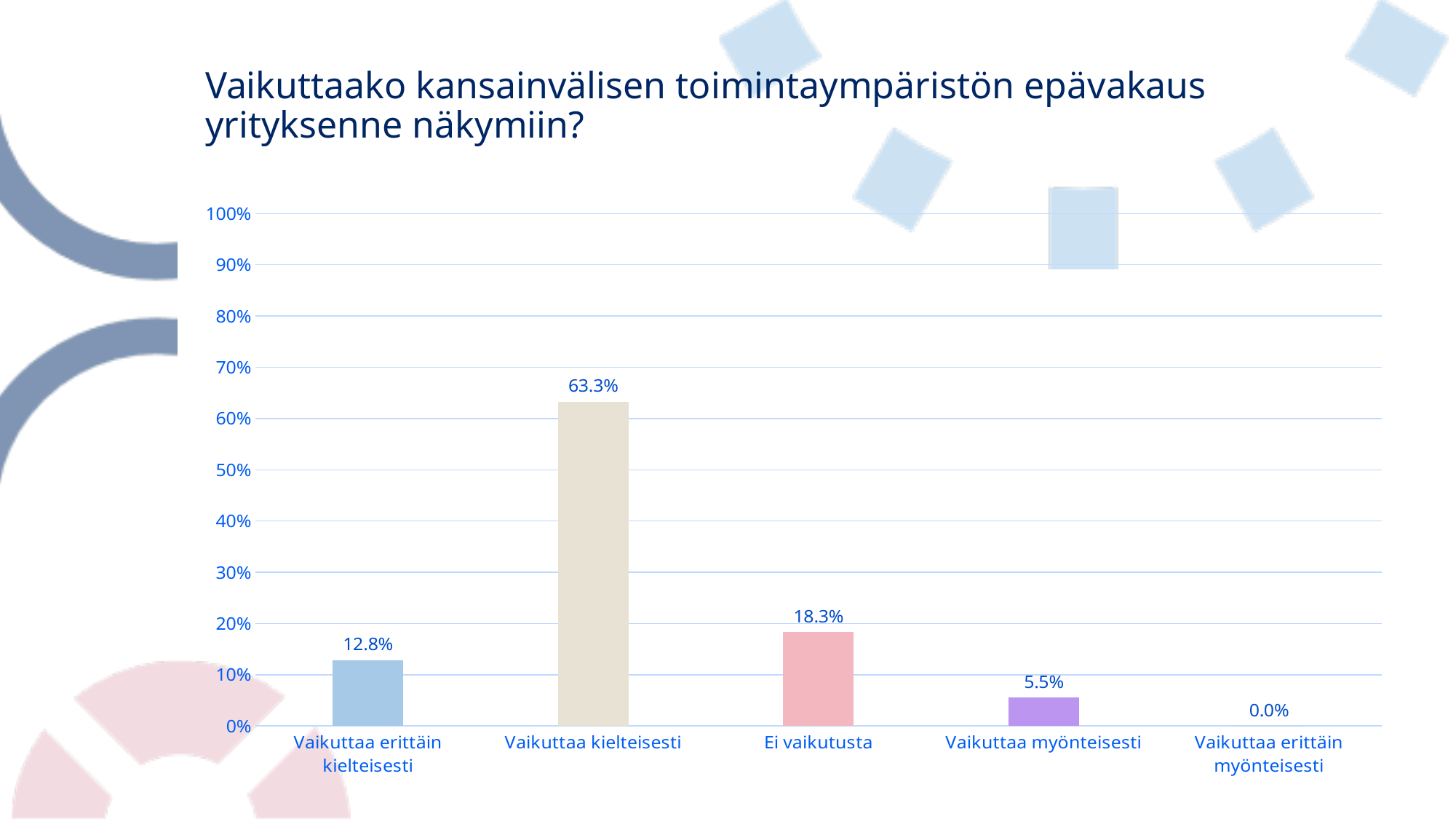
Which is larger, the value for "Ei vaikutusta" or the value for "Vaikuttaa erittäin kielteisesti"? Ei vaikutusta Which category has the highest value? Vaikuttaa kielteisesti What is the value for "Vaikuttaa erittäin kielteisesti"? 12.8% What is the title of the slide? Vaikuttaako kansainvälisen toimintaympäristön epävakaus yrityksenne näkymiin? What is the value for "Vaikuttaa erittäin myönteisesti"? 0.0% What is the difference between the values for "Vaikuttaa kielteisesti" and "Ei vaikutusta"? 45.0% Which category has the lowest value? Vaikuttaa erittäin myönteisesti What is the value for "Vaikuttaa myönteisesti"? 5.5% How many categories are shown on the x axis? 5 What is the value for "Vaikuttaa kielteisesti"? 63.3% What is the value for "Ei vaikutusta"? 18.3% What kind of chart is shown on the slide? Bar chart